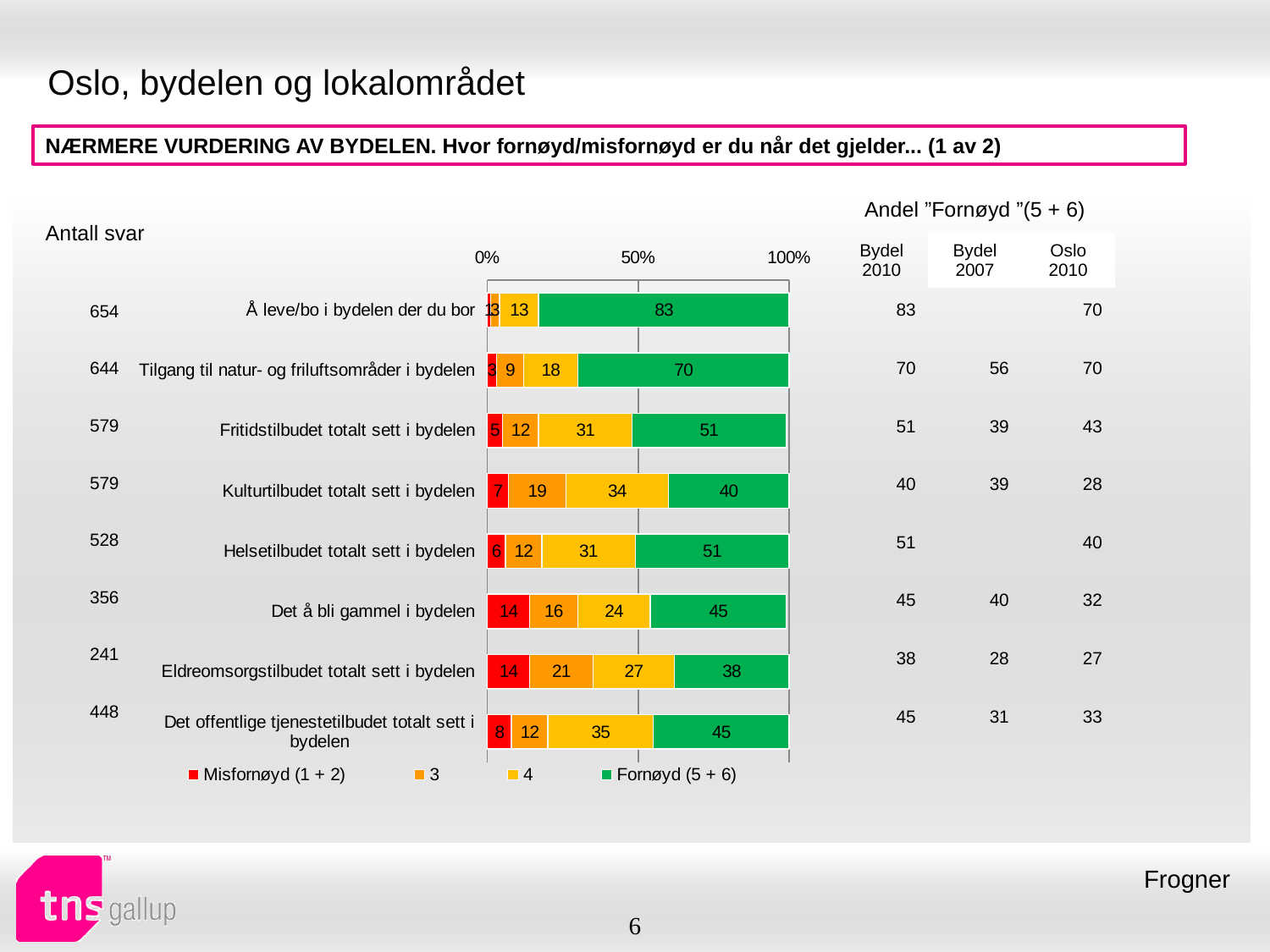
What is the total of the stacked bar for 'Kulturtilbudet totalt sett i bydelen'? 100 How many series does the chart legend list? 4 What is the value of series '4' for 'Kulturtilbudet totalt sett i bydelen'? 34 Which has a larger Fornøyd (5 + 6) value: 'Fritidstilbudet totalt sett i bydelen' or 'Eldreomsorgstilbudet totalt sett i bydelen'? Fritidstilbudet totalt sett i bydelen What is the Misfornøyd (1 + 2) value for 'Eldreomsorgstilbudet totalt sett i bydelen'? 14 Which category has the lowest Fornøyd (5 + 6) value? Eldreomsorgstilbudet totalt sett i bydelen How many categories are plotted in the chart? 8 Which category has the highest Fornøyd (5 + 6) value? Å leve/bo i bydelen der du bor What is the value of series '3' for 'Det å bli gammel i bydelen'? 16 What is the difference between the Fornøyd (5 + 6) values for 'Tilgang til natur- og friluftsområder i bydelen' and 'Kulturtilbudet totalt sett i bydelen'? 30 What kind of chart is shown on the slide? Stacked bar chart What is the Fornøyd (5 + 6) value for 'Å leve/bo i bydelen der du bor'? 83